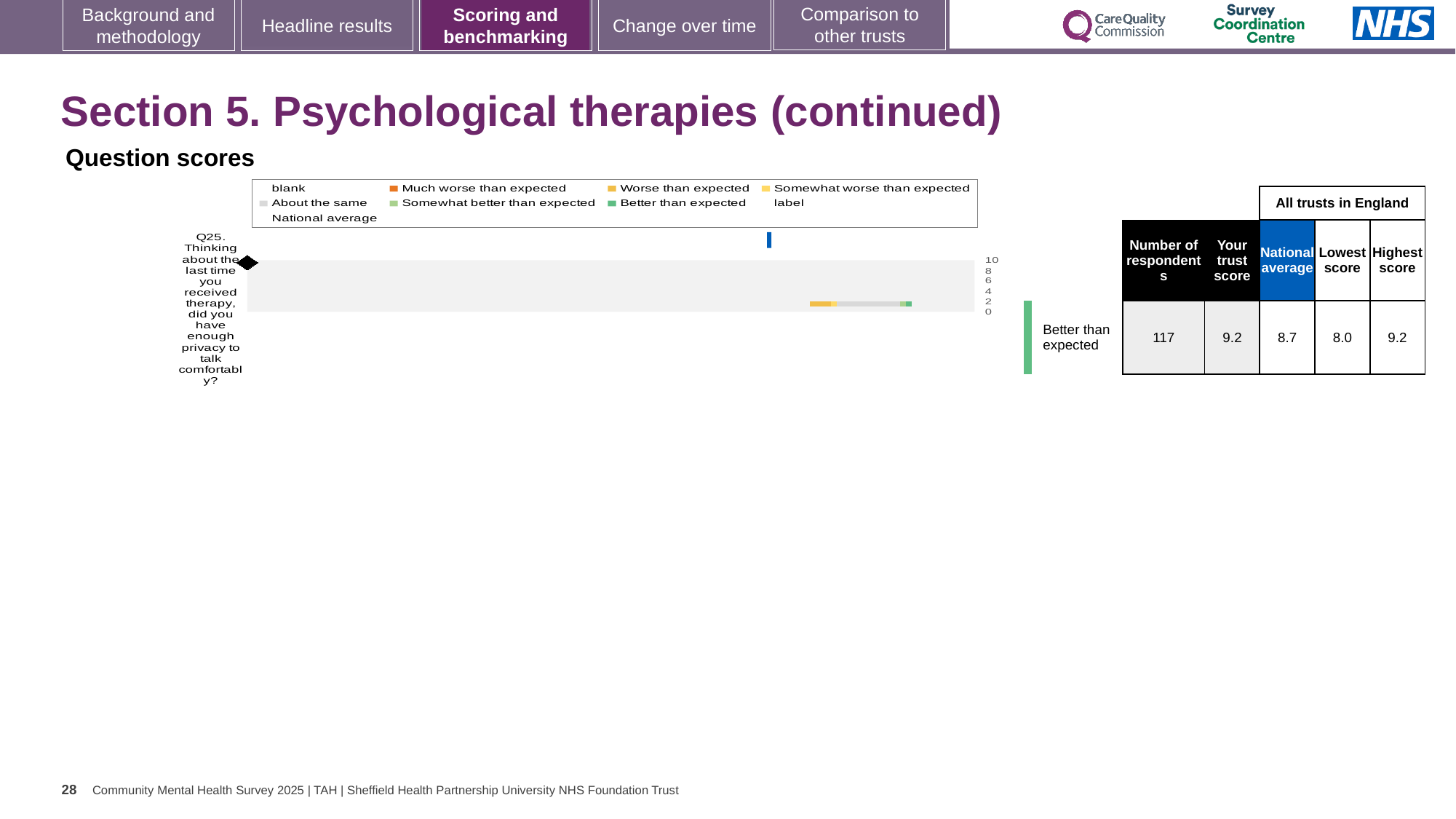
What benchmark category label is shown next to the Q25 bar? Better than expected For Q25, which is larger: your trust score or the national average? Your trust score Which question is plotted in the Question scores chart? Q25. Thinking about the last time you received therapy, did you have enough privacy to talk comfortably? For Q25, what is the difference between the highest score and the lowest score among all trusts in England? 1.2 In the table beside the chart, what is the number of respondents for Q25? 117 In the table beside the chart, what is the highest score among all trusts in England for Q25? 9.2 How many questions (categories) are plotted in the Question scores chart? 1 For Q25, what is the difference between your trust score and the national average? 0.5 In the table beside the chart, what is the lowest score among all trusts in England for Q25? 8.0 What kind of chart is shown under "Question scores"? bar chart In the table beside the chart, what is your trust score for Q25? 9.2 In the table beside the chart, what is the national average for Q25? 8.7